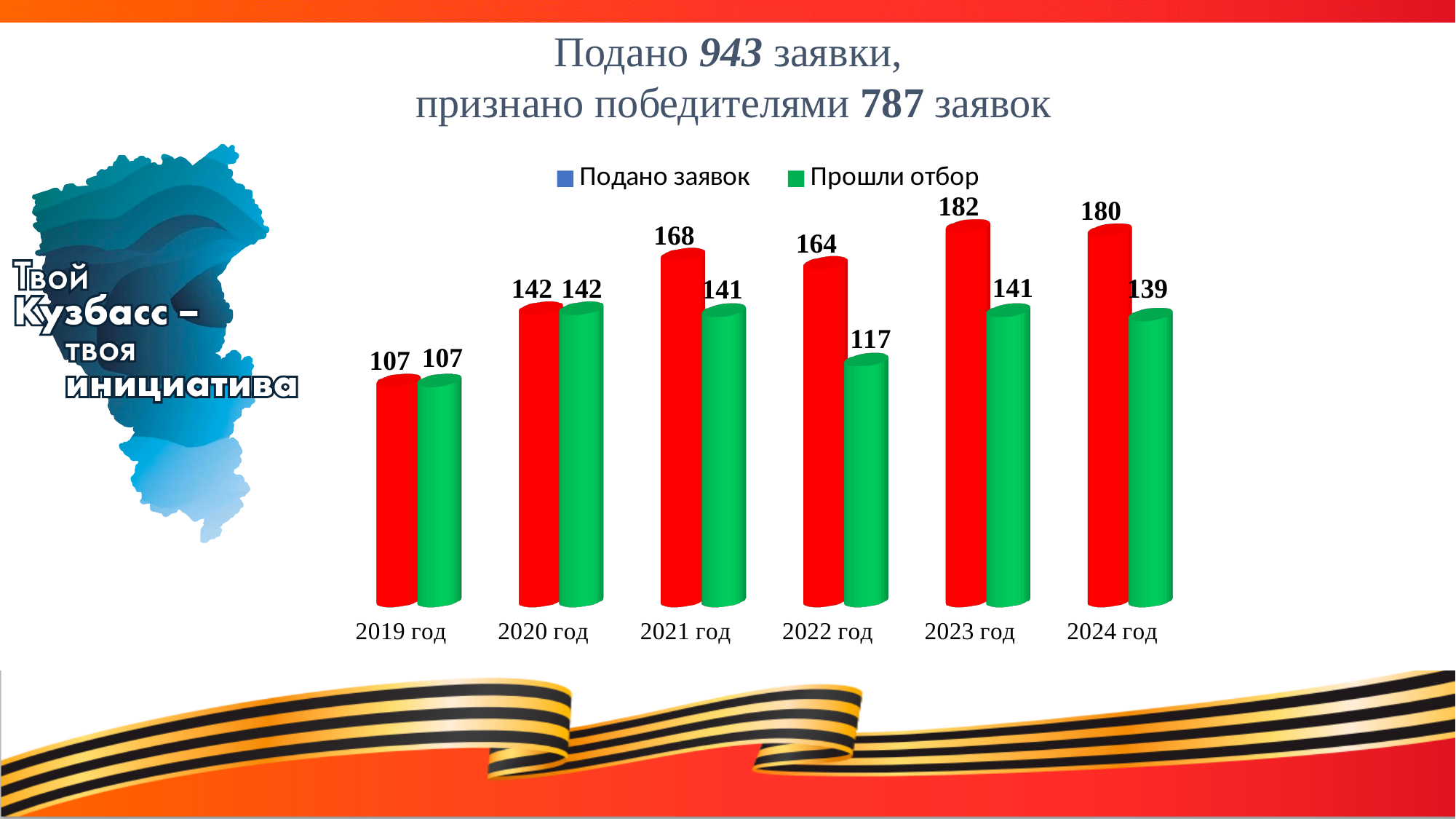
What is the value of Подано заявок for 2021 год? 168 What is the value of Прошли отбор for 2024 год? 139 What kind of chart is shown on the slide? bar chart How many years are shown on the x axis? 6 What is the difference between Подано заявок and Прошли отбор in 2022 год? 47 Which year has the highest value for Подано заявок? 2023 год Which is larger: Прошли отбор in 2021 год or Прошли отбор in 2022 год? 2021 год Does the value of Подано заявок rise or fall from 2019 год to 2021 год? rise What is the difference between Подано заявок in 2023 год and in 2019 год? 75 How many series does the legend list? 2 What is the value of Прошли отбор for 2022 год? 117 Which year has the lowest value for Прошли отбор? 2019 год